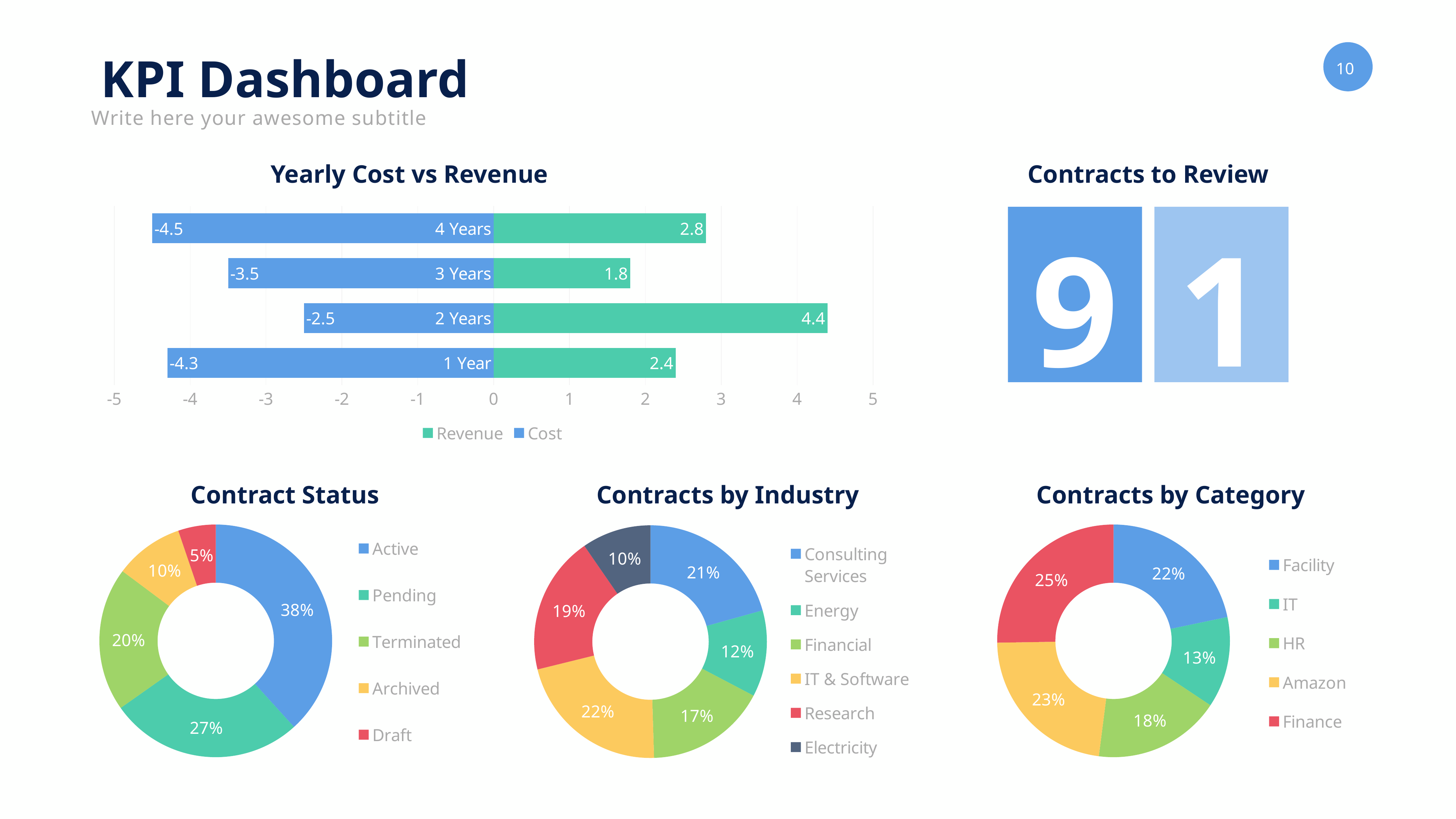
In the Yearly Cost vs Revenue chart, how many series does the legend list? 2 In the Contract Status chart, what share is Pending? 27% In the Contracts by Industry chart, what is the share for IT & Software? 22% In the Yearly Cost vs Revenue chart, what is the Revenue value for 2 Years? 4.4 In the Yearly Cost vs Revenue chart, what is the Cost value for 1 Year? -4.3 In the Yearly Cost vs Revenue chart, what is the difference between the Revenue for 4 Years and the Revenue for 3 Years? 1.0 In the Contracts by Category chart, which is larger, Amazon or HR? Amazon In the Yearly Cost vs Revenue chart, which category has the highest Revenue? 2 Years In the Contracts by Category chart, which category has the largest share? Finance In the Contract Status chart, which status has the smallest share? Draft What kind of chart is the Yearly Cost vs Revenue chart? Bar chart In the Contracts by Industry chart, how many industries are shown? 6